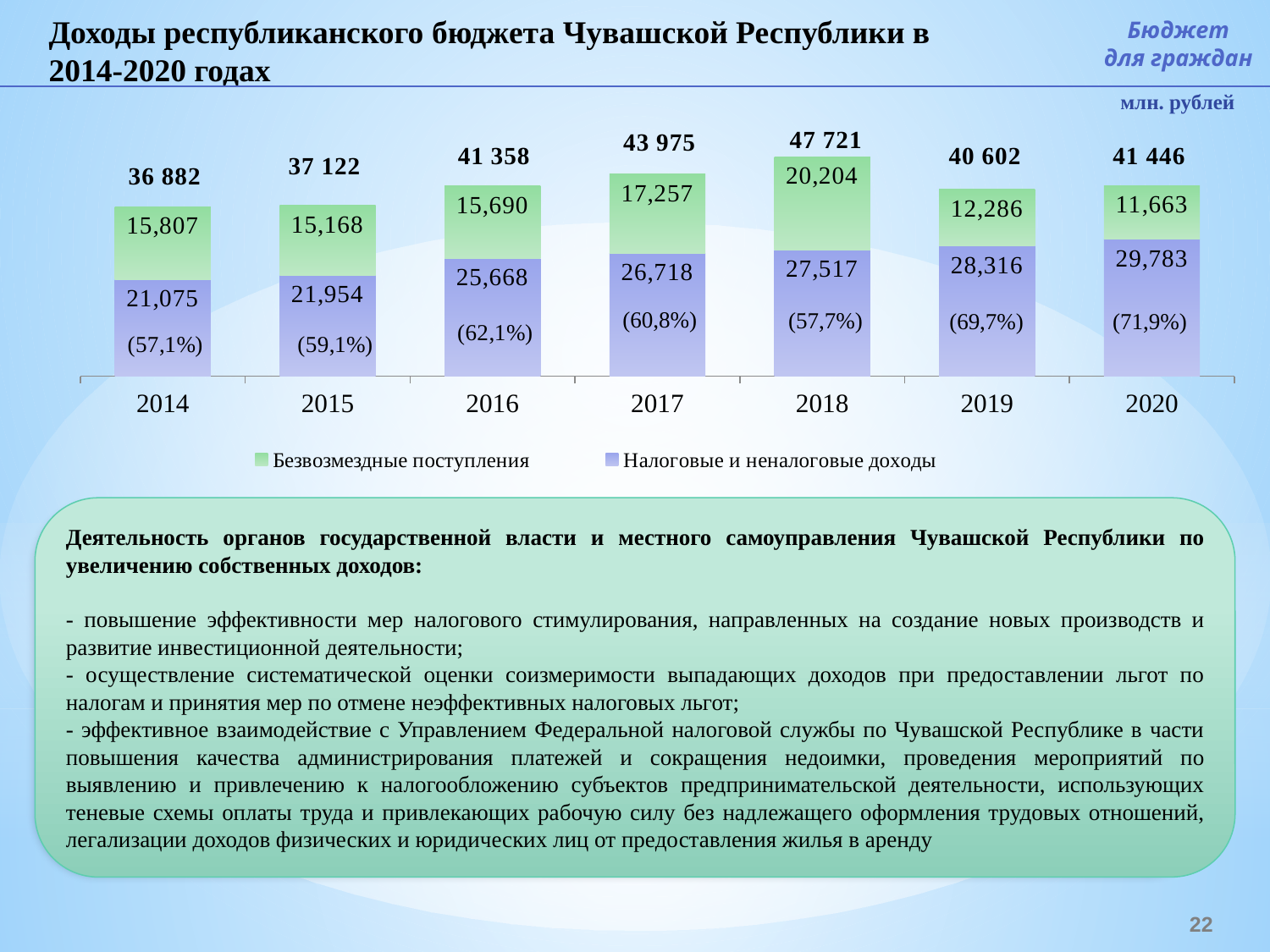
Which series is shown in green in the chart legend? Безвозмездные поступления What is the total revenue shown above the bar for 2017? 43 975 What share of total revenue do "Налоговые и неналоговые доходы" make up in 2020, as printed on the chart? (71,9%) How many years are shown on the x axis of the chart? 7 Which is larger: "Безвозмездные поступления" in 2015 or in 2019? 2015 How many series does the chart legend list? 2 What is the difference between the "Налоговые и неналоговые доходы" values for 2020 and 2014? 8,708 Which year has the highest total revenue? 2018 What type of chart is shown on the slide? Stacked bar chart What is the value of "Налоговые и неналоговые доходы" for 2016? 25,668 Which year has the lowest total revenue? 2014 What is the value of "Безвозмездные поступления" for 2018? 20,204